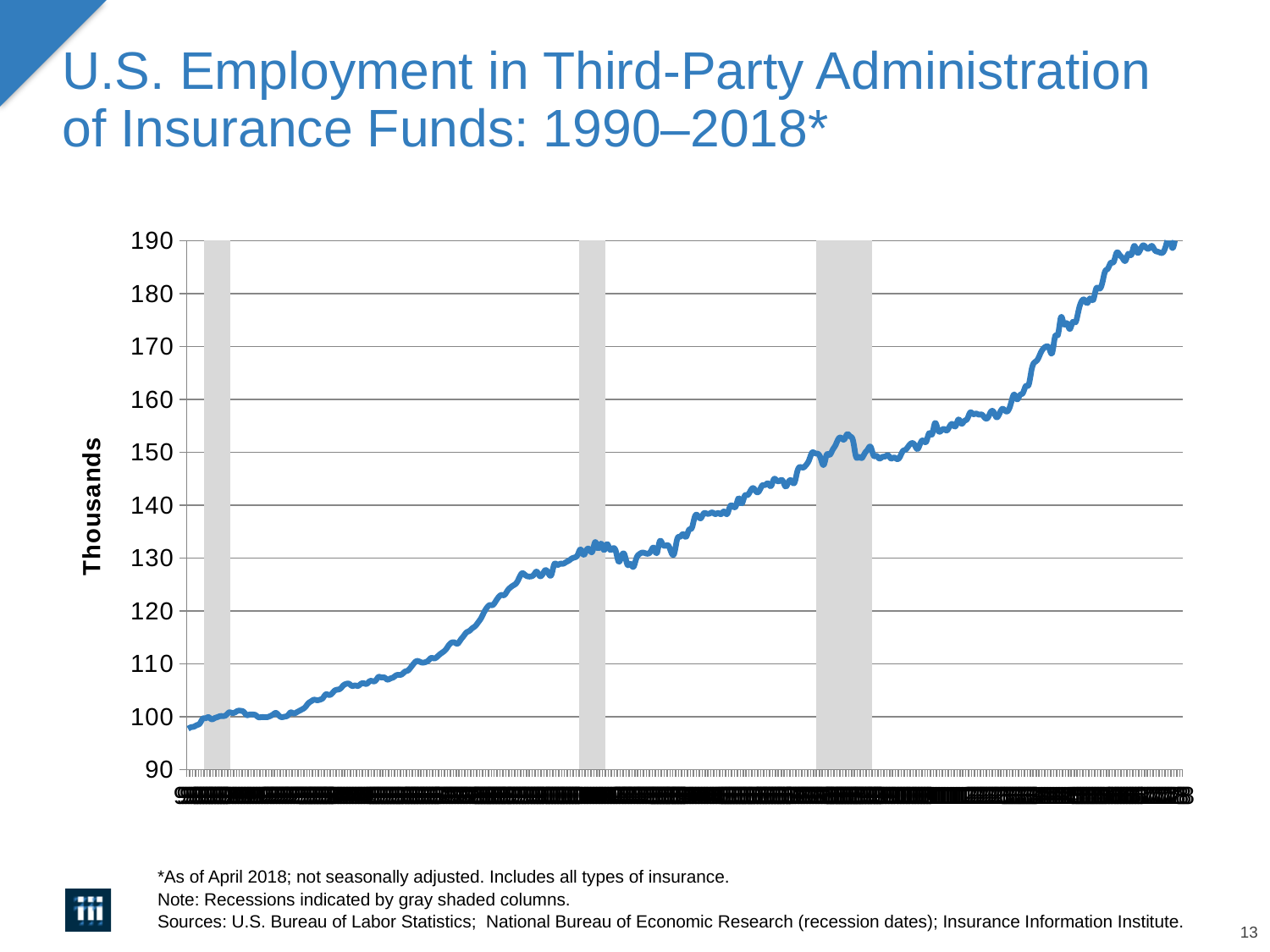
Is the value at the end of the series (right end of the line) greater or less than 180? greater Is the value at the start of the rightmost gray shaded column greater or less than 140? greater What is the label on the vertical axis? Thousands Is the value at the start of the series (left end of the line) greater or less than 110? less Is the value at the end of the series greater or less than the value at the start of the series? greater How many gray shaded recession columns are shown on the chart? 3 What kind of chart is shown on the slide? line chart Overall, do the values rise or fall from left to right along the x axis? rise What is the highest tick value shown on the vertical axis? 190